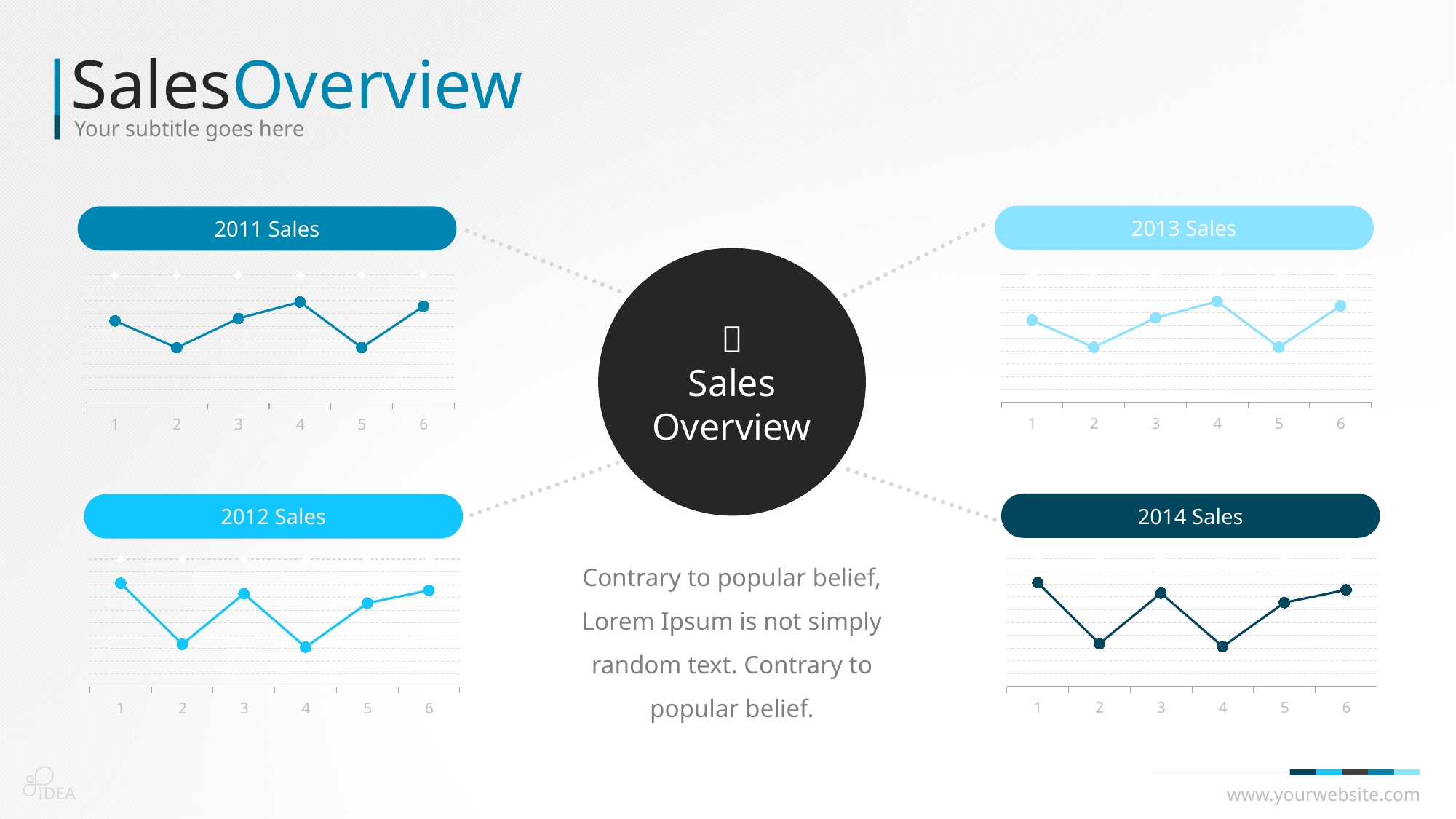
On the 2011 Sales chart, does the value rise or fall from point 1 to point 2? fall On the 2013 Sales chart, which is larger, the value at point 3 or the value at point 2? point 3 What kind of chart is the 2011 Sales chart? line chart What is the title of the chart in the bottom-right of the slide? 2014 Sales On the 2013 Sales chart, which point on the x axis has the highest value? 4 On the 2011 Sales chart, which point on the x axis has the highest value? 4 On the 2014 Sales chart, which is larger, the value at point 1 or the value at point 4? point 1 On the 2012 Sales chart, which is larger, the value at point 1 or the value at point 2? point 1 On the 2014 Sales chart, does the value rise or fall from point 4 to point 6? rise How many sales charts are shown on the slide? 4 How many data points are plotted on the 2012 Sales chart? 6